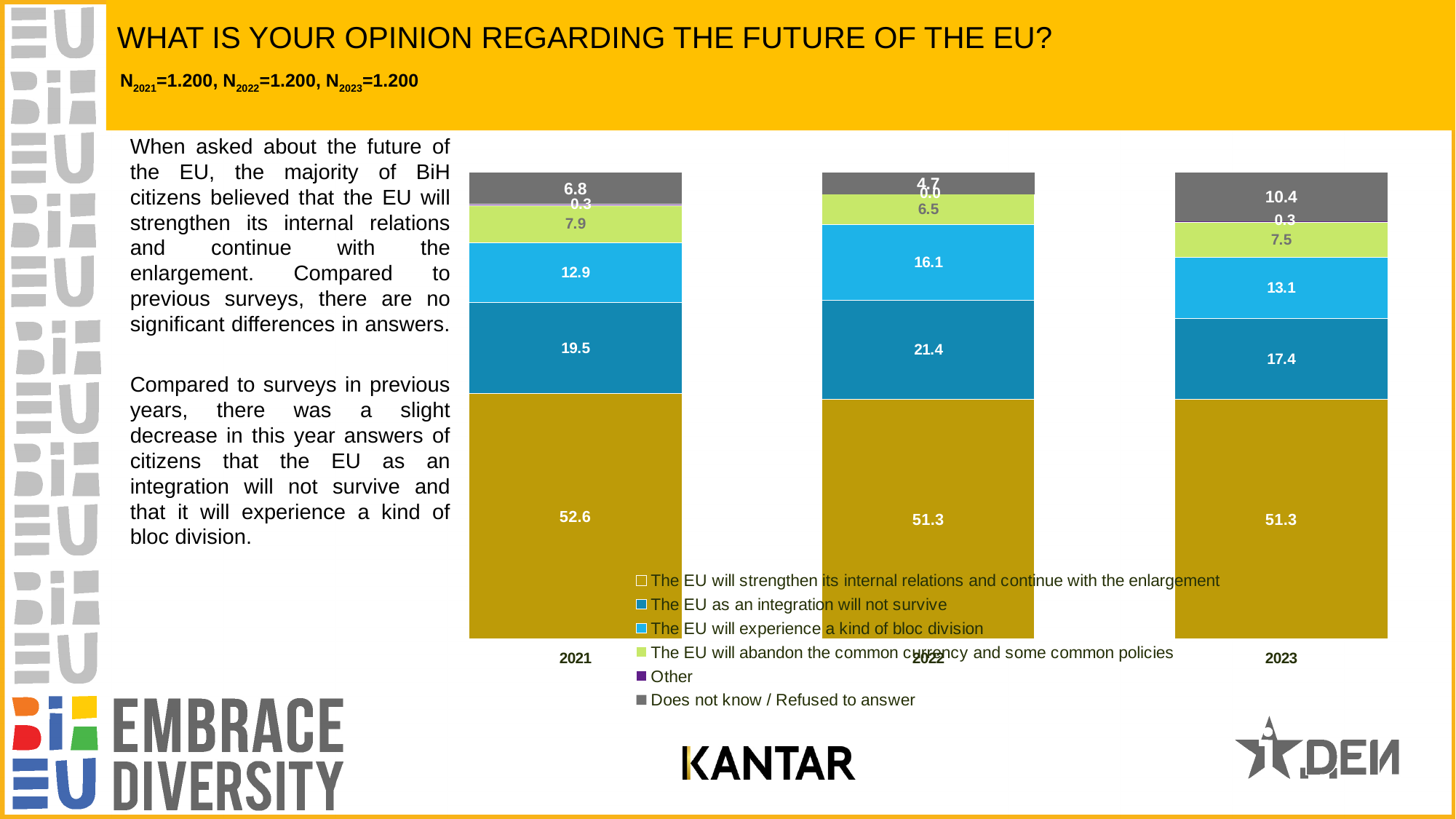
In which year is the value for 'Does not know / Refused to answer' lowest? 2022 What is the difference between the 2022 and 2023 values for 'The EU as an integration will not survive'? 4.0 What is the value for 'Does not know / Refused to answer' in 2023? 10.4 In which year is the value for 'The EU will experience a kind of bloc division' highest? 2022 What is the total of the stacked bar for 2023? 100.0 How many years (bars) are shown on the x axis? 3 What kind of chart is shown on the slide? stacked bar chart Which is larger: the 2021 value for 'The EU will abandon the common currency and some common policies' or the 2022 value? 2021 How many series does the legend list? 6 What is the value for 'The EU will experience a kind of bloc division' in 2023? 13.1 What is the value for 'The EU will strengthen its internal relations and continue with the enlargement' in 2021? 52.6 What is the value for 'The EU as an integration will not survive' in 2022? 21.4